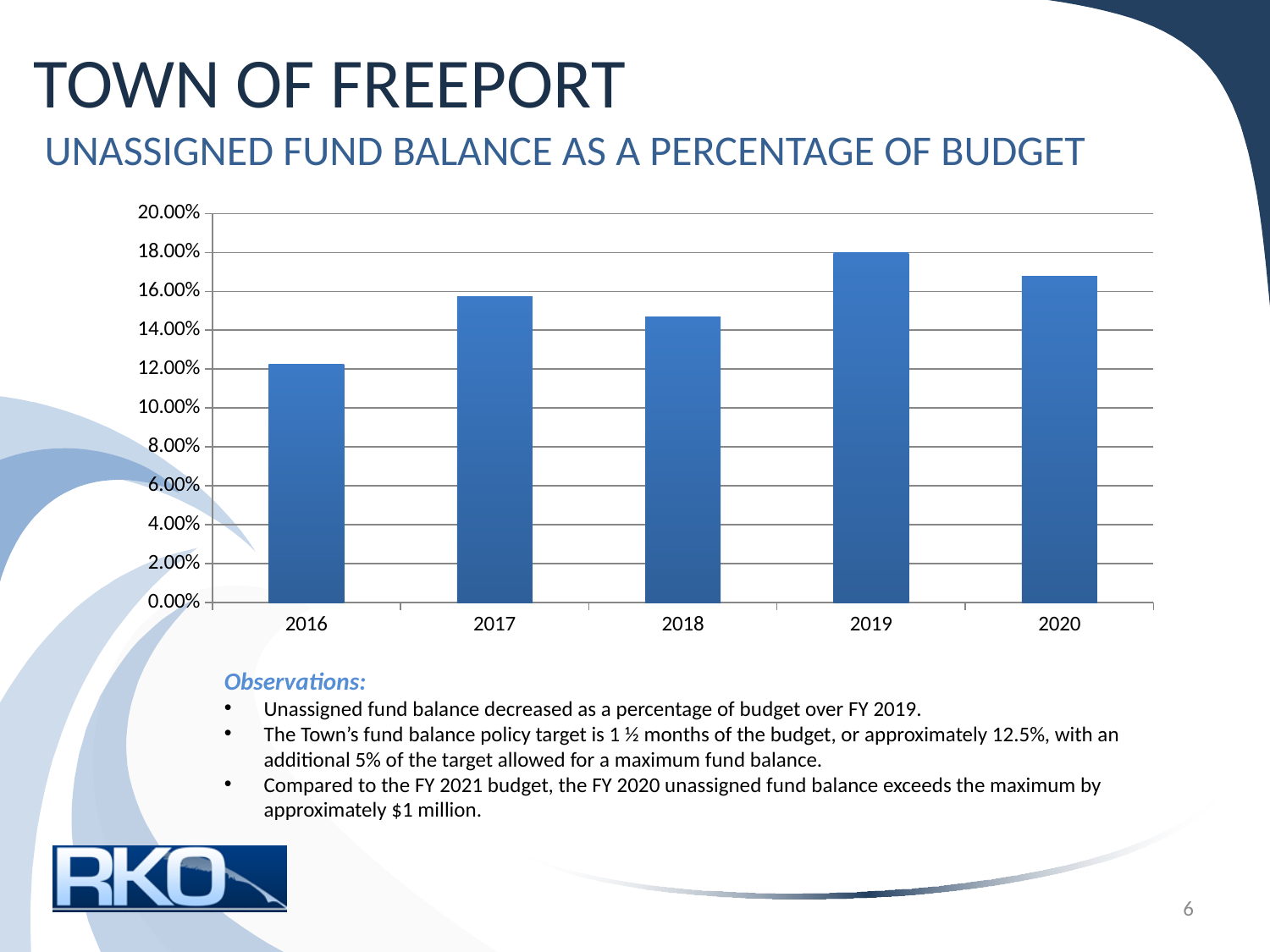
Is the value for 2020 greater or less than 16.00%? greater What kind of chart is shown on the slide? bar chart Is the value for 2017 greater or less than 14.00%? greater Did the unassigned fund balance as a percentage of budget rise or fall from 2019 to 2020? fall What is the highest value shown on the chart's vertical axis? 20.00% Which year has the larger value, 2017 or 2018? 2017 Is the value for 2016 greater or less than 14.00%? less Which year has the lowest unassigned fund balance as a percentage of budget? 2016 How many years are shown on the x axis of the chart? 5 Which year has the larger value, 2020 or 2017? 2020 Which year has the highest unassigned fund balance as a percentage of budget? 2019